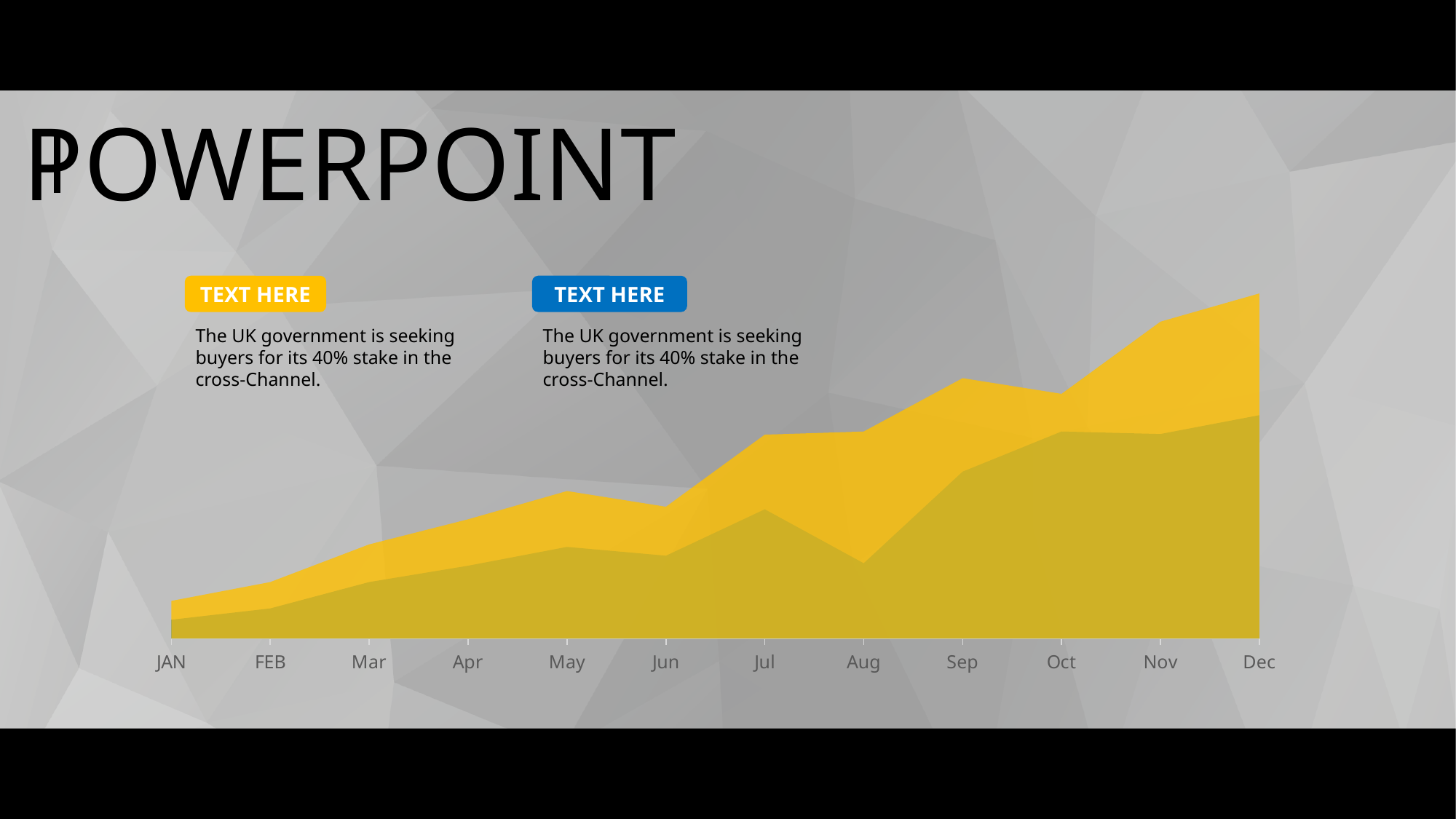
For the upper (lighter yellow) area, which month has the larger value, May or Jun? May In which month does the lower (darker yellow) area reach its highest value? Dec In which month is the lower (darker yellow) area at its lowest value? JAN How many months are shown along the x axis of the chart? 12 In which month does the upper (lighter yellow) area reach its highest value? Dec In which month is the upper (lighter yellow) area at its lowest value? JAN For the upper (lighter yellow) area, which month has the larger value, Nov or Dec? Dec For the lower (darker yellow) area, which month has the larger value, Jul or Aug? Jul How many data series (shaded areas) are plotted in the chart? 2 What is the first category label on the x axis of the chart? JAN Do the values in the chart generally rise or fall from JAN to Dec? Rise What kind of chart is shown on the slide? Area chart